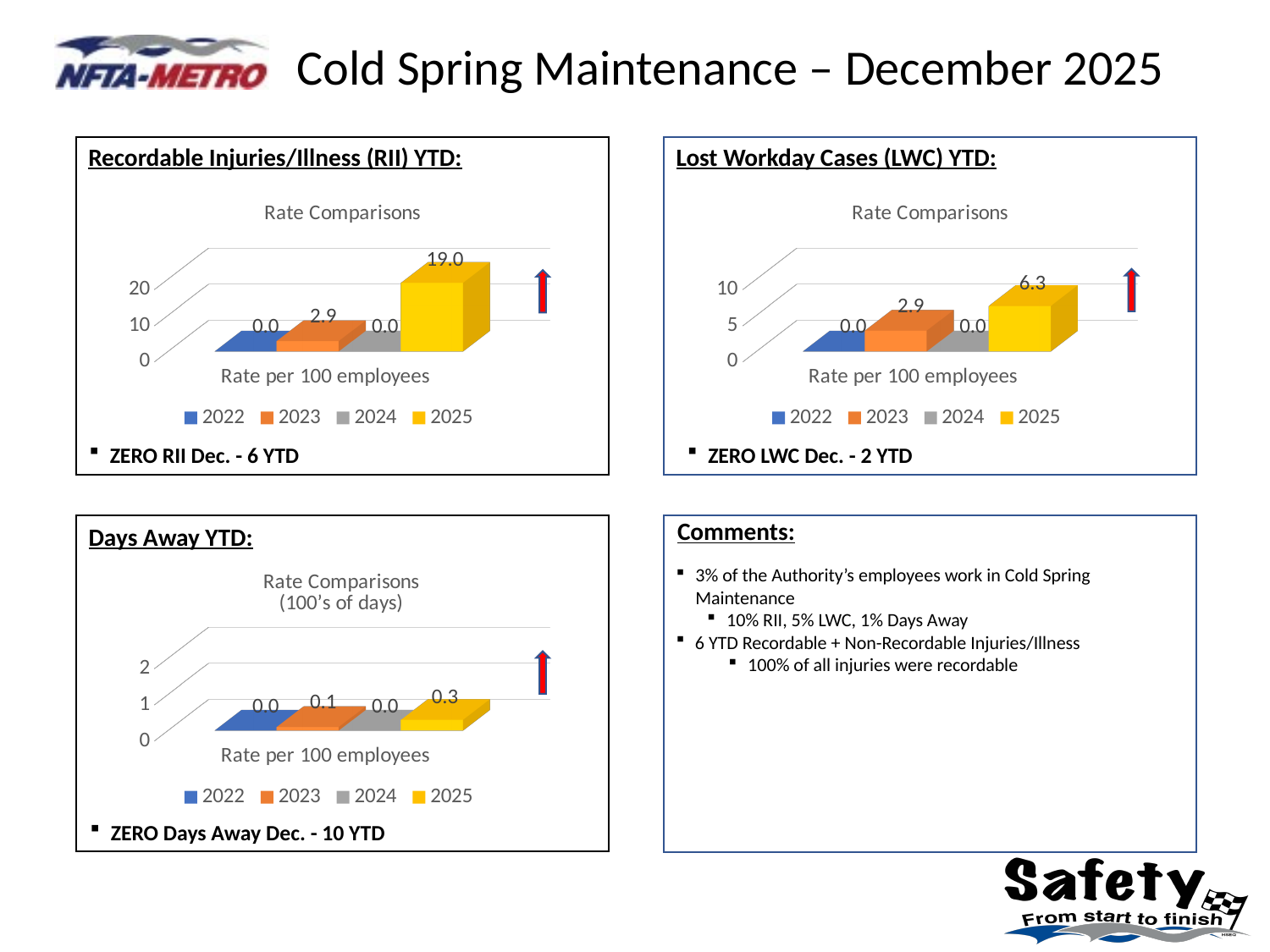
In the Days Away YTD chart, what is the value for 2023? 0.1 What kind of chart is the Lost Workday Cases (LWC) YTD chart? Bar chart In the Recordable Injuries/Illness (RII) YTD chart, which year has the highest rate? 2025 In the Lost Workday Cases (LWC) YTD chart, what is the value for 2025? 6.3 In the Recordable Injuries/Illness (RII) YTD chart, what is the value for 2025? 19.0 In the Lost Workday Cases (LWC) YTD chart, which is larger, the value for 2023 or the value for 2025? 2025 In the Recordable Injuries/Illness (RII) YTD chart, what is the value for 2023? 2.9 How many series does the legend of the Days Away YTD chart list? 4 In the Recordable Injuries/Illness (RII) YTD chart, what is the difference between the 2025 and 2023 values? 16.1 In the Lost Workday Cases (LWC) YTD chart, what is the difference between the 2025 and 2023 values? 3.4 What is the title shown on the Days Away YTD chart? Rate Comparisons (100's of days) In the Days Away YTD chart, what is the value for 2025? 0.3